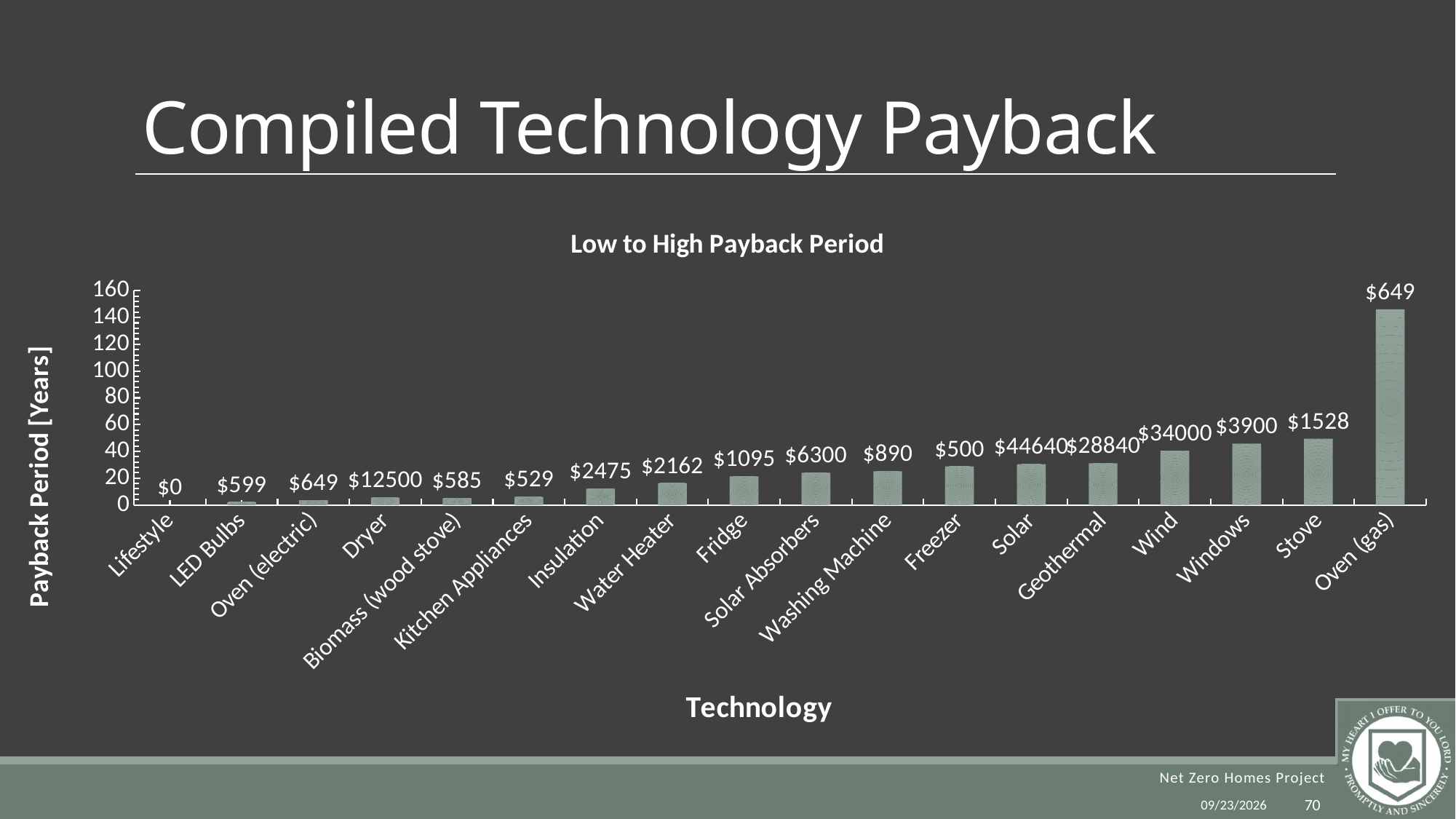
What is the title of the chart? Low to High Payback Period Which technology has the lowest payback period in the chart? Lifestyle Is the payback period for Fridge greater or less than 40 years? less What is the label of the vertical axis of the chart? Payback Period [Years] Which technology has the highest payback period in the chart? Oven (gas) Which has the larger payback period, Stove or Wind? Stove What data label is printed above the bar for Solar? $44640 Is the payback period for Oven (gas) greater or less than 100 years? greater What type of chart is shown on the slide? bar chart Do the bar heights rise or fall moving from left to right along the x axis? rise Is the payback period for Stove greater or less than 60 years? less How many technologies (categories) are shown on the x axis of the chart? 18